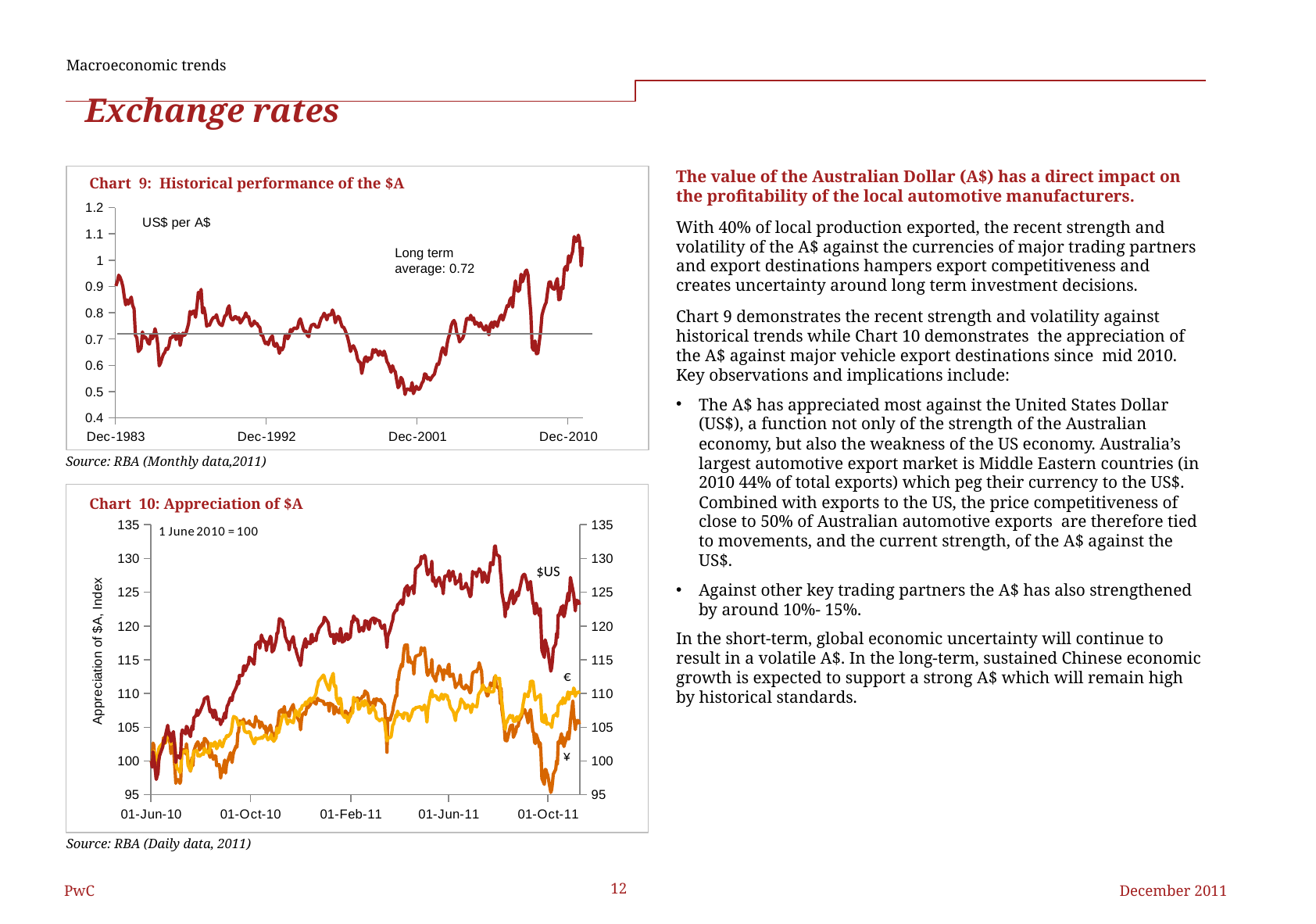
In Chart 10: Appreciation of $A, which currency series reaches the highest index value? $US In Chart 10: Appreciation of $A, is the $US series at 01-Jun-11 greater or less than 120? greater In Chart 9: Historical performance of the $A, what unit is the exchange rate expressed in, as labelled on the chart? US$ per A$ In Chart 9: Historical performance of the $A, is the value at Dec-2010 greater or less than 0.9? greater In Chart 9: Historical performance of the $A, does the exchange rate rise or fall between Dec-2001 and Dec-2010? rise In Chart 9: Historical performance of the $A, what long term average is printed on the chart? 0.72 What kind of chart is Chart 9: Historical performance of the $A? line chart What kind of chart is Chart 10: Appreciation of $A? line chart In Chart 10: Appreciation of $A, does the $US series rise or fall between 01-Jun-10 and 01-Jun-11? rise In Chart 9: Historical performance of the $A, is the value around Dec-2001 greater or less than 0.6? less How many currency series are plotted in Chart 10: Appreciation of $A? 3